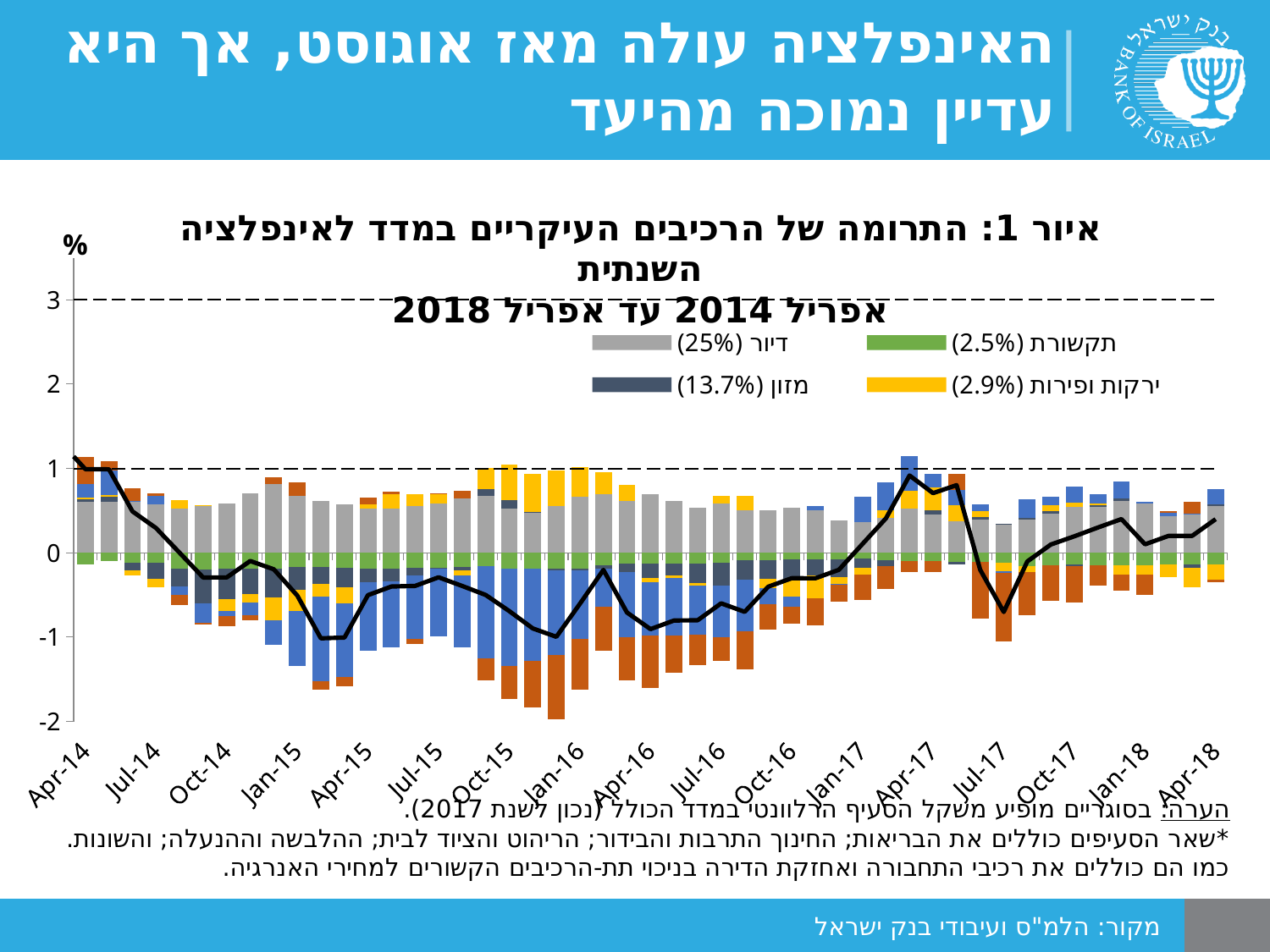
How many date labels are shown on the x axis? 17 What weight is shown in the legend for דיור? 25% Does the line rise or fall from Jan-17 to Apr-17? rise What is the title of the chart? איור 1: התרומה של הרכיבים העיקריים במדד לאינפלציה השנתית אפריל 2014 עד אפריל 2018 Is the value of the line at Apr-18 greater or less than 1? less Does the line rise or fall from Apr-14 to Jan-15? fall Is the value of the line at Jul-17 greater or less than 0? less Is the value of the line at Apr-18 greater or less than 0? greater What kind of chart is shown on the slide? Stacked bar chart with a line What is the highest tick value shown on the y axis? 3 How many series does the visible legend list? 4